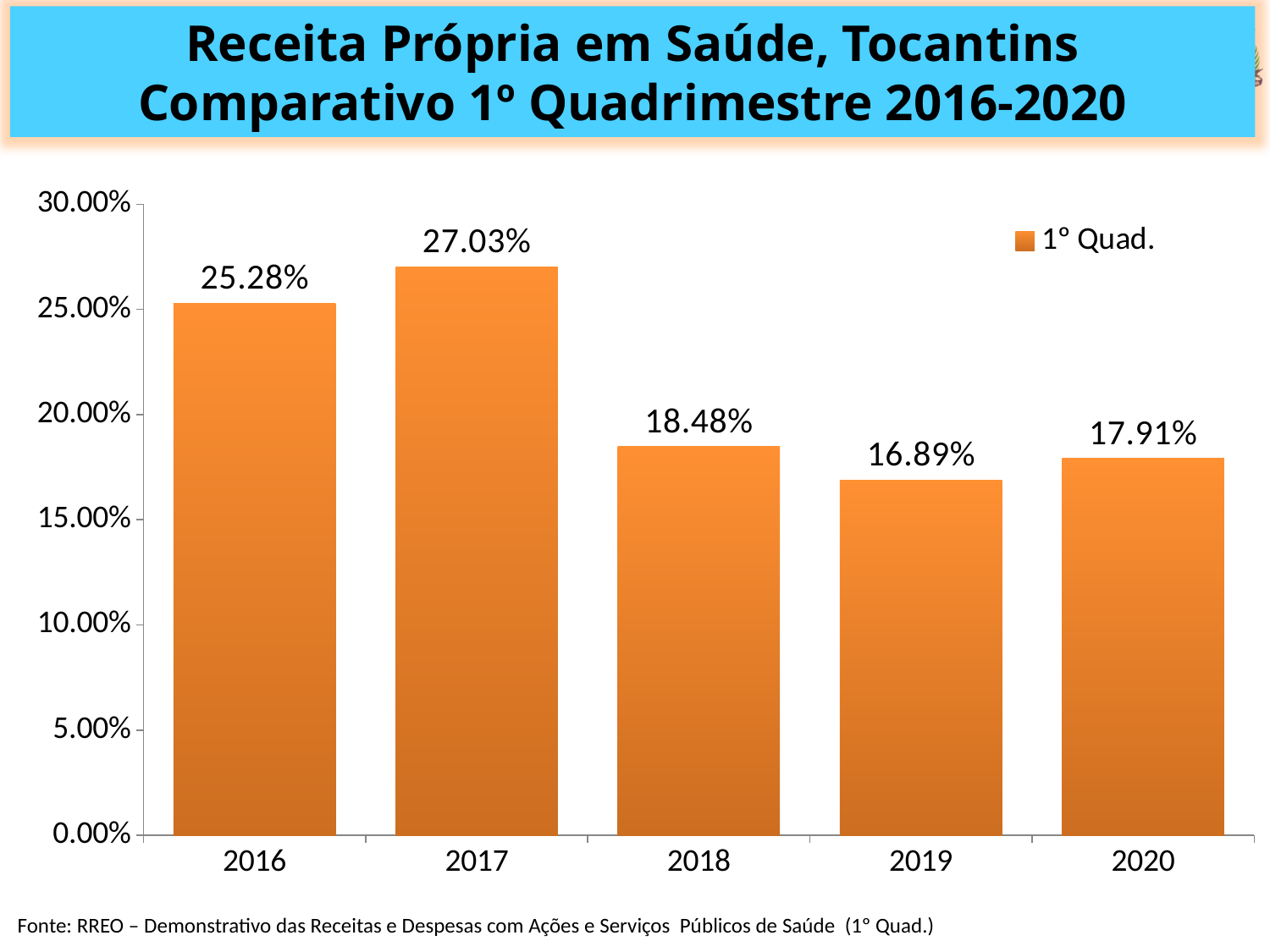
What is the difference between the values for 2017 and 2016? 1.75% What kind of chart is shown on the slide? bar chart Which year has the lowest value? 2019 Is the value for 2019 greater or less than 20.00%? less How many years are shown on the x axis? 5 What is the value for 2016? 25.28% Which year has the highest value? 2017 What series name does the legend show? 1° Quad. What is the value for 2019? 16.89% Which is larger, the value for 2018 or the value for 2020? 2018 What is the difference between the values for 2018 and 2019? 1.59% What is the value for 2020? 17.91%